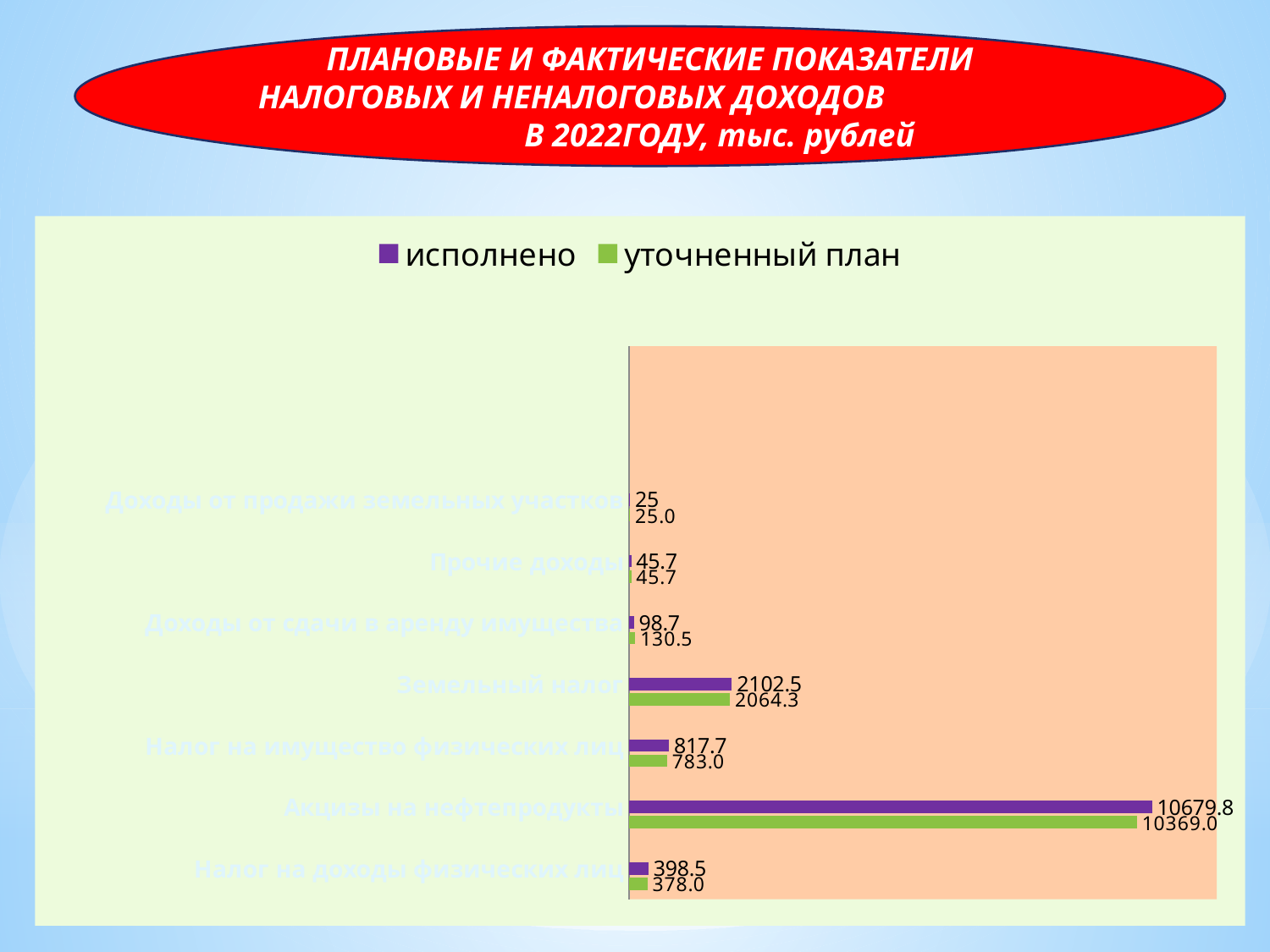
How many categories are plotted in the chart? 7 What is the 'исполнено' value for Акцизы на нефтепродукты? 10679.8 What is the 'уточненный план' value for Доходы от сдачи в аренду имущества? 130.5 Which category has the highest 'исполнено' value? Акцизы на нефтепродукты How many series does the legend list? 2 What kind of chart is shown on the slide? bar chart What is the 'уточненный план' value for Земельный налог? 2064.3 What is the difference between the 'исполнено' and 'уточненный план' values for Налог на имущество физических лиц? 34.7 For Доходы от сдачи в аренду имущества, which is larger: 'исполнено' or 'уточненный план'? уточненный план Which colour represents the 'уточненный план' series in the legend? green What is the 'исполнено' value for Налог на доходы физических лиц? 398.5 Which category has the lowest 'уточненный план' value? Доходы от продажи земельных участков